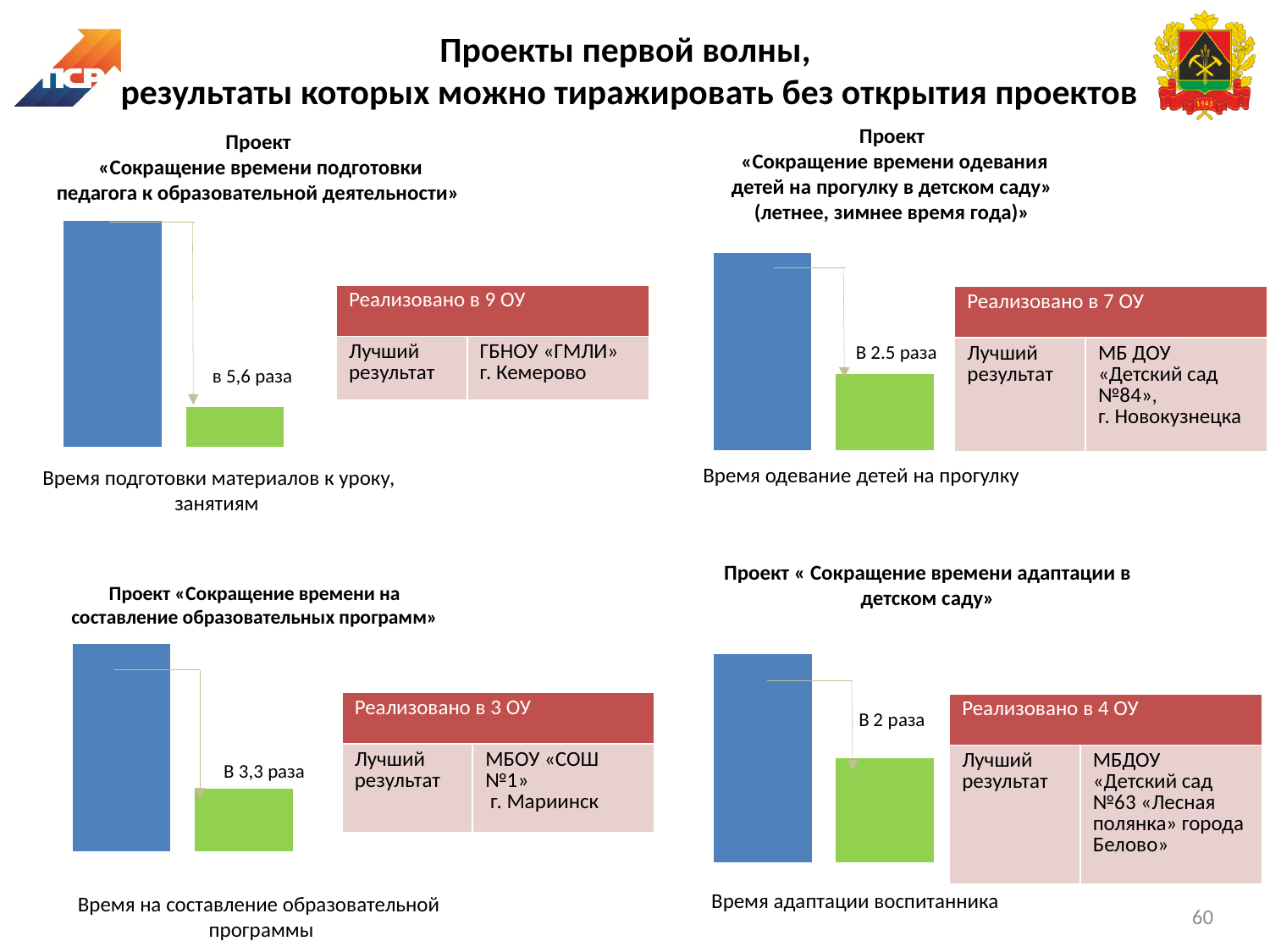
What caption is written under the chart for the project «Сокращение времени одевания детей на прогулку в детском саду»? Время одевание детей на прогулку On the chart for the project «Сокращение времени подготовки педагога к образовательной деятельности», by what factor was the time reduced according to the label? в 5,6 раза On the chart for the project «Сокращение времени адаптации в детском саду», do the values rise or fall from the left bar to the right bar? fall How many bars are plotted on the chart for the project «Сокращение времени одевания детей на прогулку в детском саду»? 2 On the chart for the project «Сокращение времени на составление образовательных программ», what reduction factor is shown? В 3,3 раза Among the four charts on the slide, which project shows the largest reduction factor? «Сокращение времени подготовки педагога к образовательной деятельности» On the chart for the project «Сокращение времени одевания детей на прогулку в детском саду», what reduction factor is printed next to the arrow? В 2.5 раза What type of chart is used for the project «Сокращение времени подготовки педагога к образовательной деятельности»? bar chart On the chart for the project «Сокращение времени на составление образовательных программ», which bar is taller, the blue one or the green one? the blue one What caption is written under the chart for the project «Сокращение времени адаптации в детском саду»? Время адаптации воспитанника On the chart for the project «Сокращение времени адаптации в детском саду», what reduction factor is shown? В 2 раза Among the four charts on the slide, which project shows the smallest reduction factor? «Сокращение времени адаптации в детском саду»